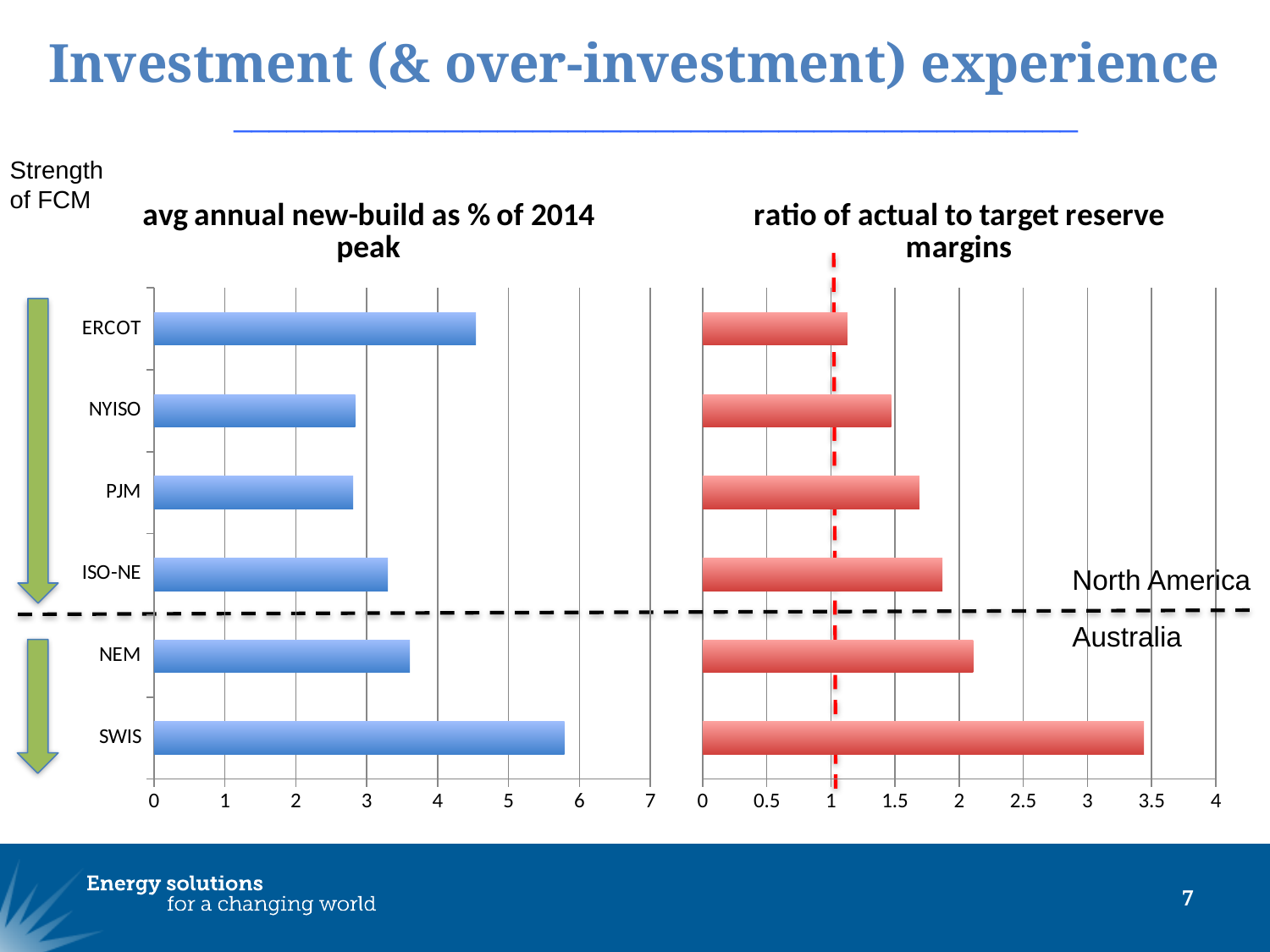
In the chart titled "ratio of actual to target reserve margins", what is the highest value shown on the horizontal axis? 4 In the chart titled "ratio of actual to target reserve margins", how many categories are plotted? 6 In the chart titled "avg annual new-build as % of 2014 peak", which category has the highest value? SWIS In the chart titled "avg annual new-build as % of 2014 peak", is the value for ERCOT greater or less than 4? greater In the chart titled "ratio of actual to target reserve margins", which category has the lowest value? ERCOT In the chart titled "avg annual new-build as % of 2014 peak", is the value for NYISO greater or less than 3? less In the chart titled "ratio of actual to target reserve margins", which category has the highest value? SWIS In the chart titled "avg annual new-build as % of 2014 peak", what kind of chart is shown? bar chart In the chart titled "avg annual new-build as % of 2014 peak", which is larger, the value for NEM or the value for ISO-NE? NEM In the chart titled "ratio of actual to target reserve margins", is the value for SWIS greater or less than 3? greater In the chart titled "ratio of actual to target reserve margins", which is larger, the value for PJM or the value for ERCOT? PJM